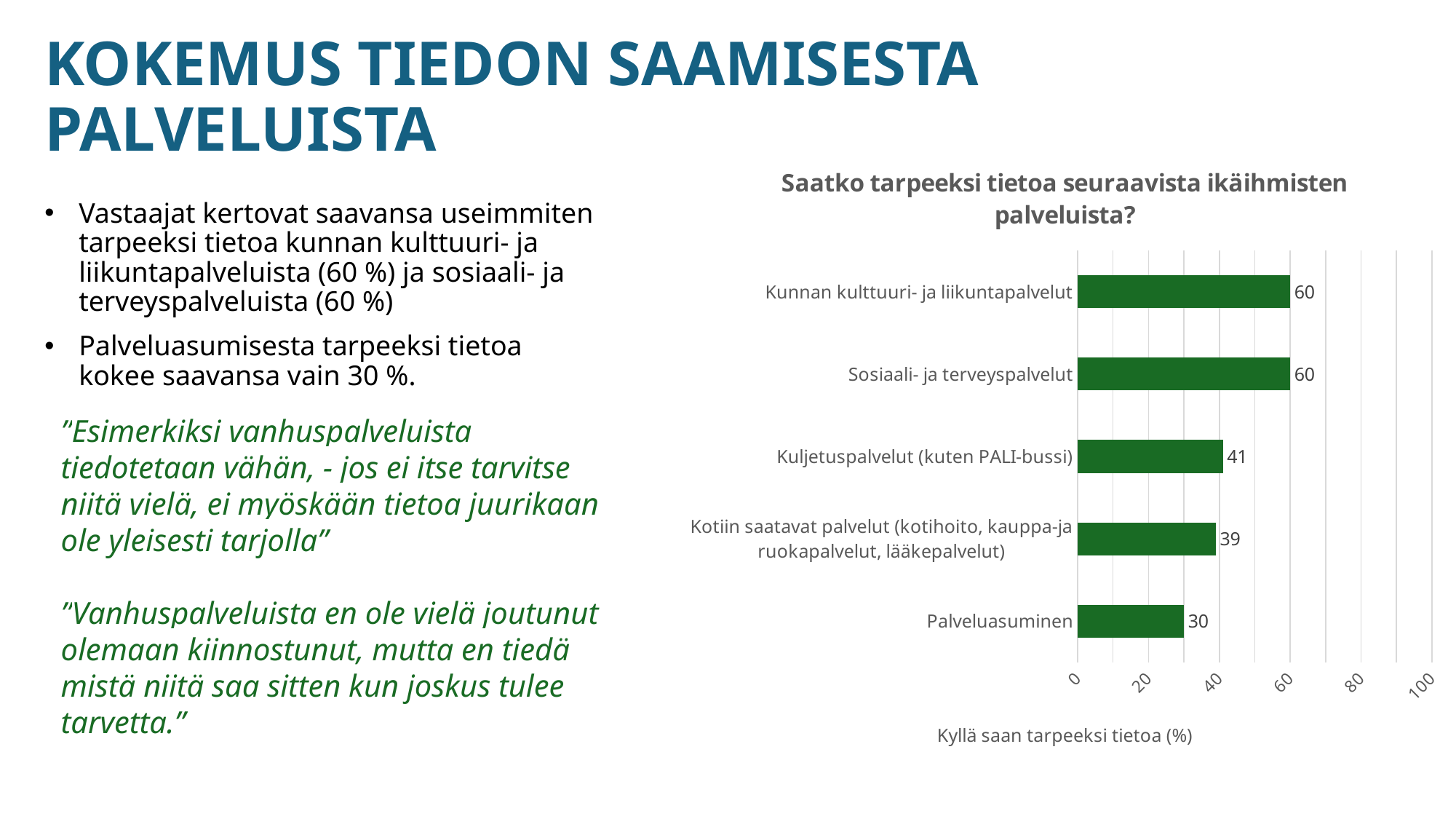
What is the difference between the values for Kuljetuspalvelut (kuten PALI-bussi) and Kotiin saatavat palvelut? 2 What is the value for Kotiin saatavat palvelut (kotihoito, kauppa-ja ruokapalvelut, lääkepalvelut)? 39 Which category has the lowest value? Palveluasuminen Which is larger, the value for Kuljetuspalvelut (kuten PALI-bussi) or the value for Palveluasuminen? Kuljetuspalvelut (kuten PALI-bussi) What is the title of the chart? Saatko tarpeeksi tietoa seuraavista ikäihmisten palveluista? Is the value for Kotiin saatavat palvelut greater or less than 40? less What kind of chart is shown on the slide? bar chart What is the value for Palveluasuminen? 30 What is the value for Kuljetuspalvelut (kuten PALI-bussi)? 41 What is the difference between the values for Kunnan kulttuuri- ja liikuntapalvelut and Palveluasuminen? 30 How many categories are shown in the chart? 5 What is the value for Sosiaali- ja terveyspalvelut? 60